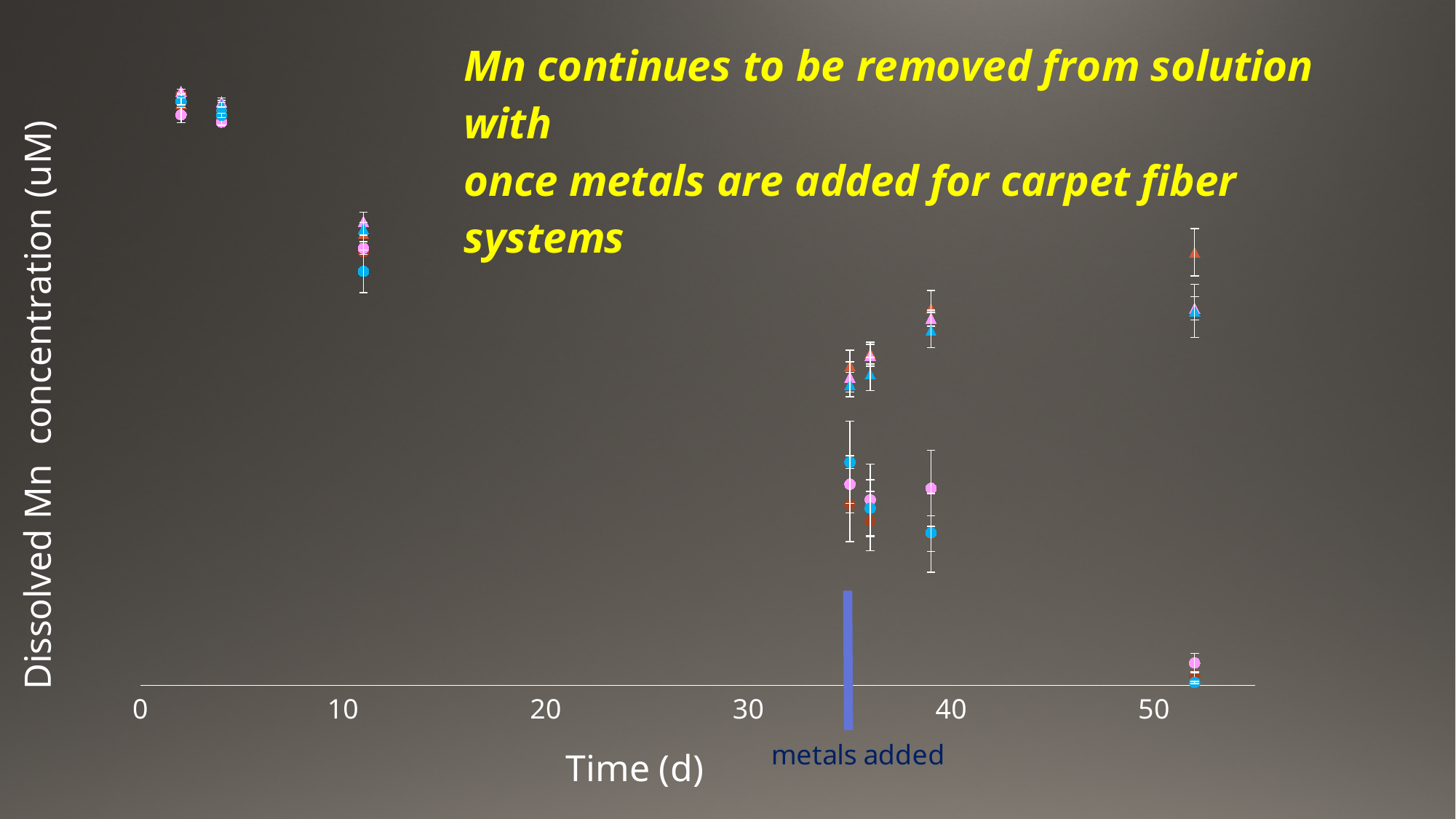
What is the label of the x axis? Time (d) How many tick labels are shown on the x axis? 6 At about day 52, are the triangle markers higher or lower than the circle markers? higher What kind of chart is shown on the slide? scatter chart Between the points near day 2 and the points near day 11, do the dissolved Mn values rise or fall? fall Is the vertical bar marking when metals were added at a time greater or less than 30 days? greater Comparing the earliest points (near day 2) with the latest circle markers (near day 52), which are higher? the points near day 2 What is the label of the y axis? Dissolved Mn concentration (uM)